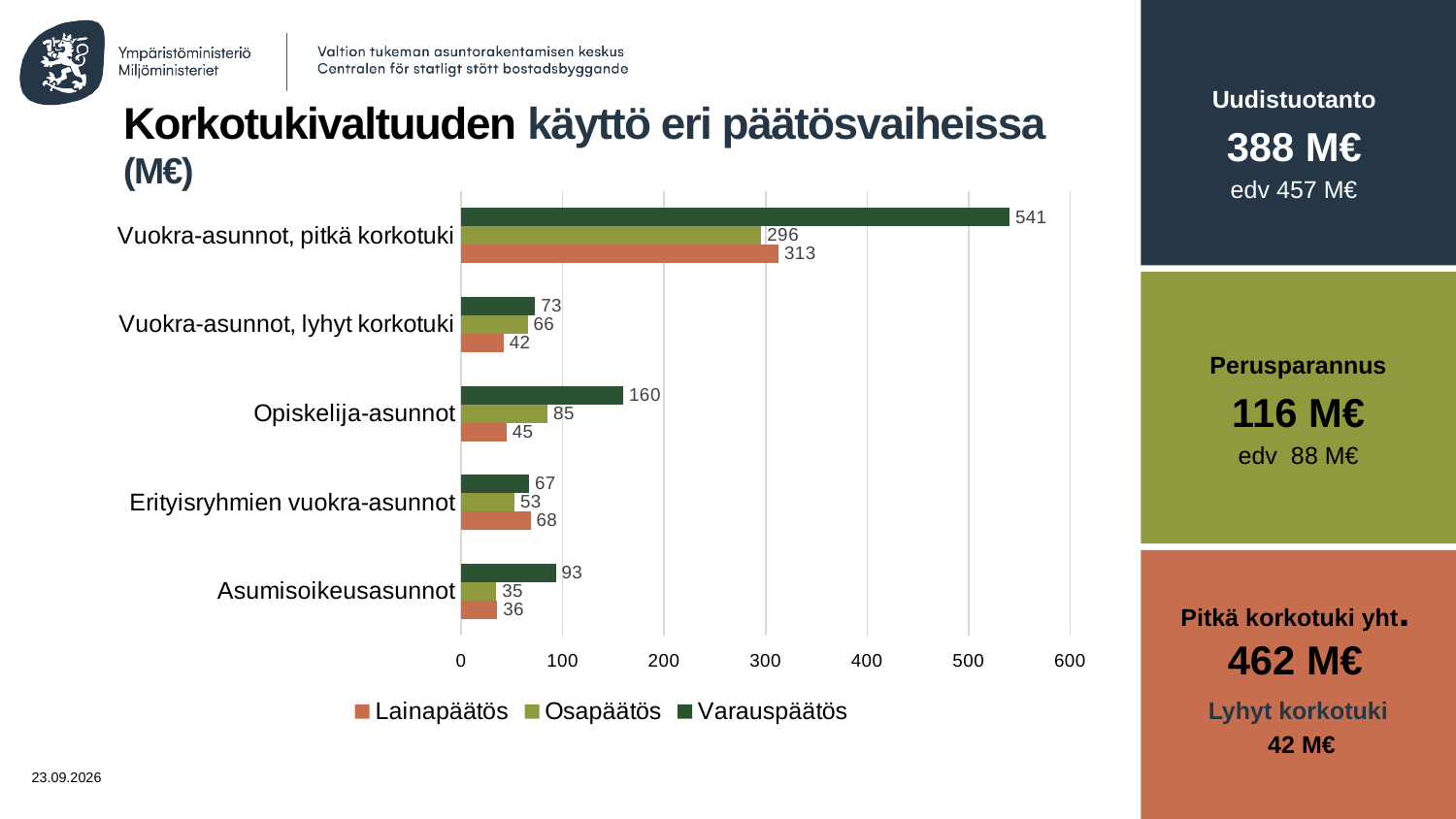
Which category has the highest Varauspäätös value? Vuokra-asunnot, pitkä korkotuki Which series is shown in orange in the legend? Lainapäätös How many categories are shown on the chart? 5 How many series does the legend list? 3 Which category has the lowest Osapäätös value? Asumisoikeusasunnot What is the Varauspäätös value for Vuokra-asunnot, pitkä korkotuki? 541 Is the Varauspäätös value for Asumisoikeusasunnot greater or less than 100? less What kind of chart is shown on the slide? Bar chart What is the difference between the Varauspäätös and Osapäätös values for Opiskelija-asunnot? 75 For Erityisryhmien vuokra-asunnot, which is larger: the Lainapäätös value or the Osapäätös value? Lainapäätös What is the Osapäätös value for Asumisoikeusasunnot? 35 What is the Lainapäätös value for Opiskelija-asunnot? 45